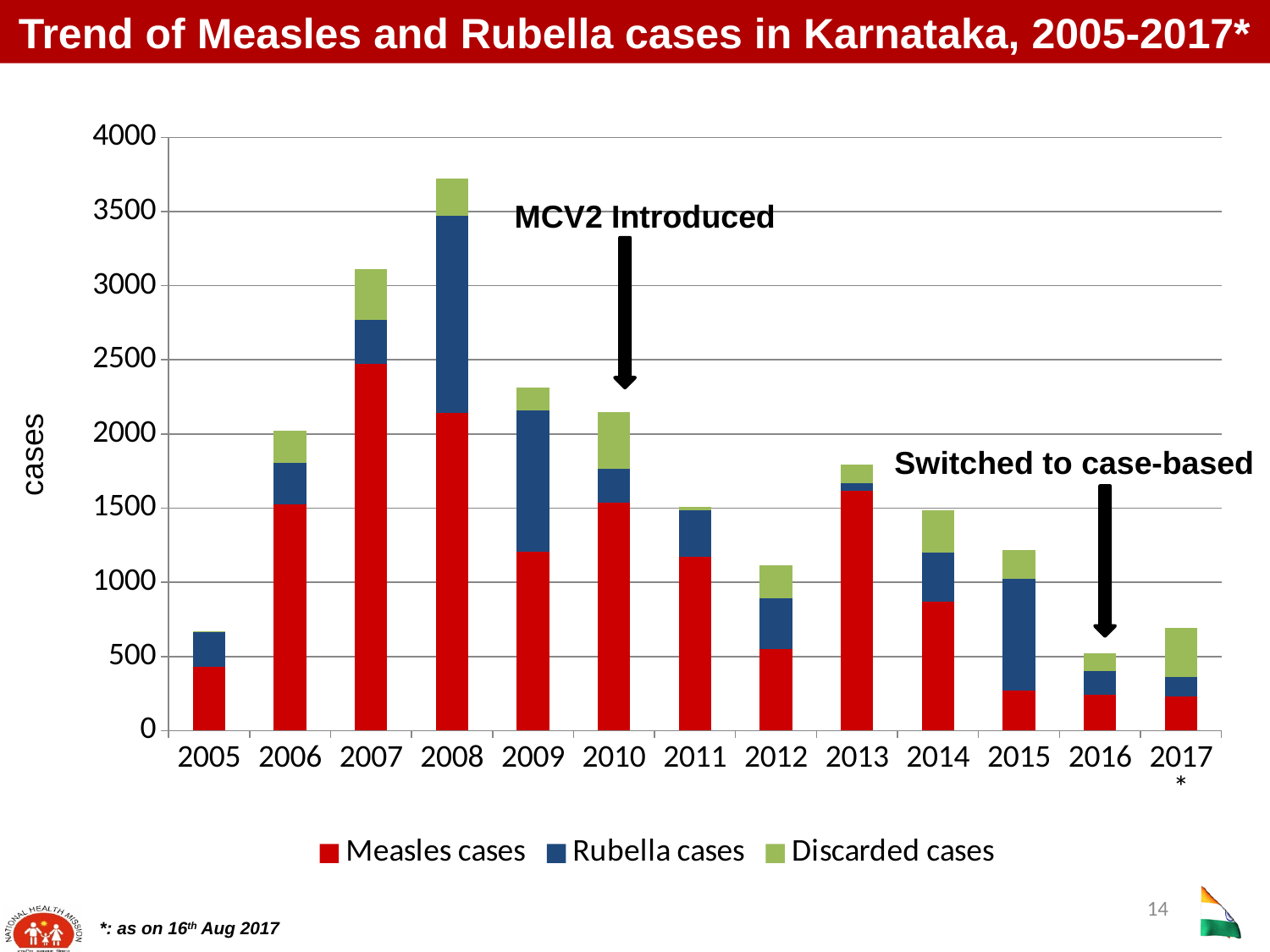
How many years are shown on the x axis of the chart? 13 Which year has the larger total number of cases, 2014 or 2015? 2014 Is the total number of cases in 2005 greater or less than 500? greater Which year has the lowest total number of cases? 2016 What kind of chart is shown on the slide? Stacked bar chart How many series does the legend list? 3 Which year has the largest number of measles cases? 2007 Is the total number of cases in 2008 greater or less than 3500? greater Do the total cases rise or fall from 2008 to 2012? Fall Is the total number of cases in 2017 greater or less than 1000? less Which colour represents measles cases in the legend? Red Which year has the highest total number of cases? 2008